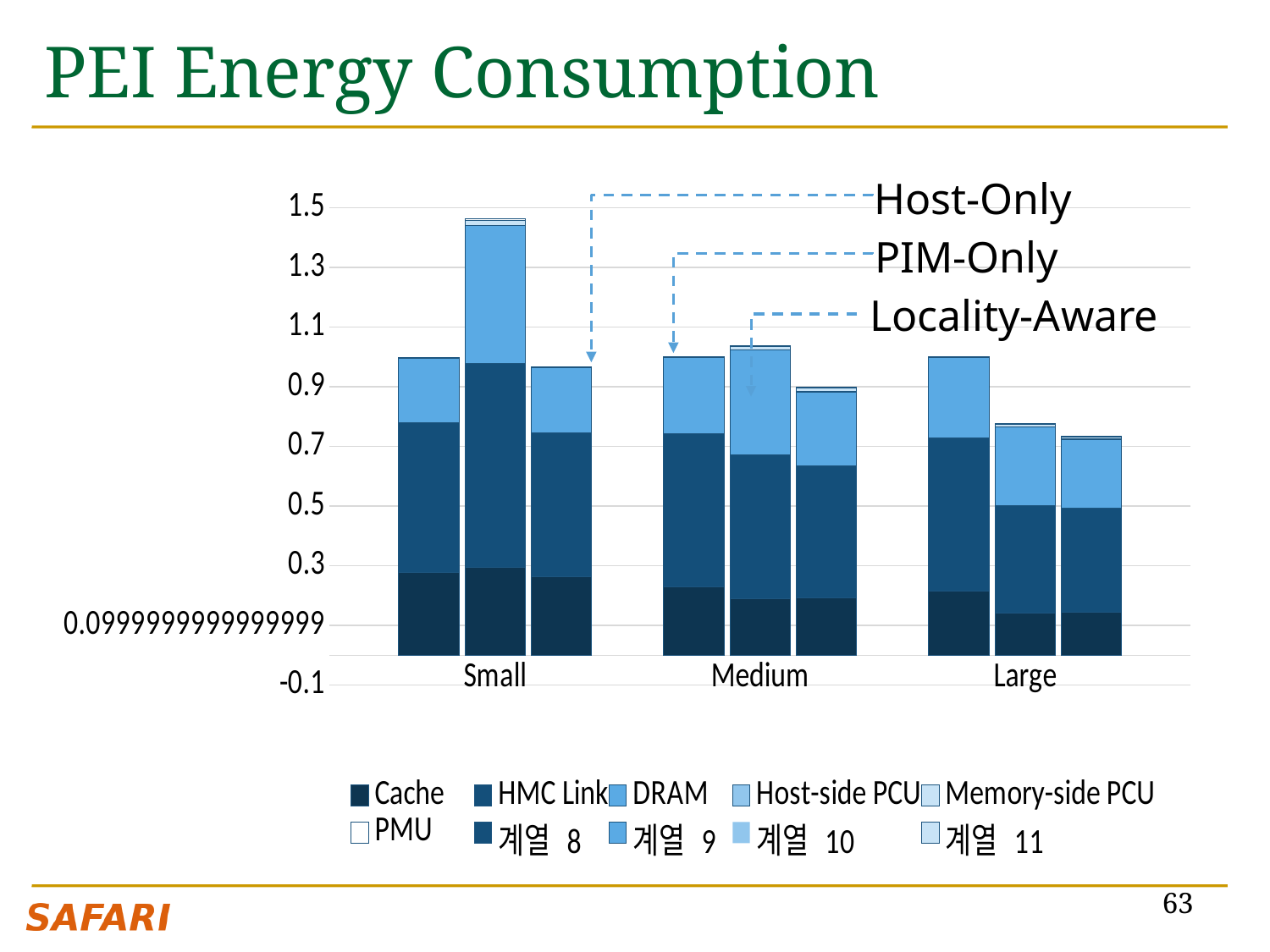
For Large, which bar is taller: Host-Only or Locality-Aware? Host-Only What kind of chart is shown on the slide? Stacked bar chart How many categories are shown on the x axis? 3 Do the Locality-Aware bar totals rise or fall from Small to Large? fall How many series does the legend list? 10 Is the total of the PIM-Only bar for Small greater or less than 1.3? greater What is the title of the chart? PEI Energy Consumption Which bar in the whole chart is the tallest? PIM-Only for Small For Small, which bar is taller: Host-Only or PIM-Only? PIM-Only Which of the three bars in each group is labeled Host-Only? The first (leftmost) bar Is the total of the PIM-Only bar for Large greater or less than 0.9? less Is the total of the Locality-Aware bar for Large greater or less than 0.9? less